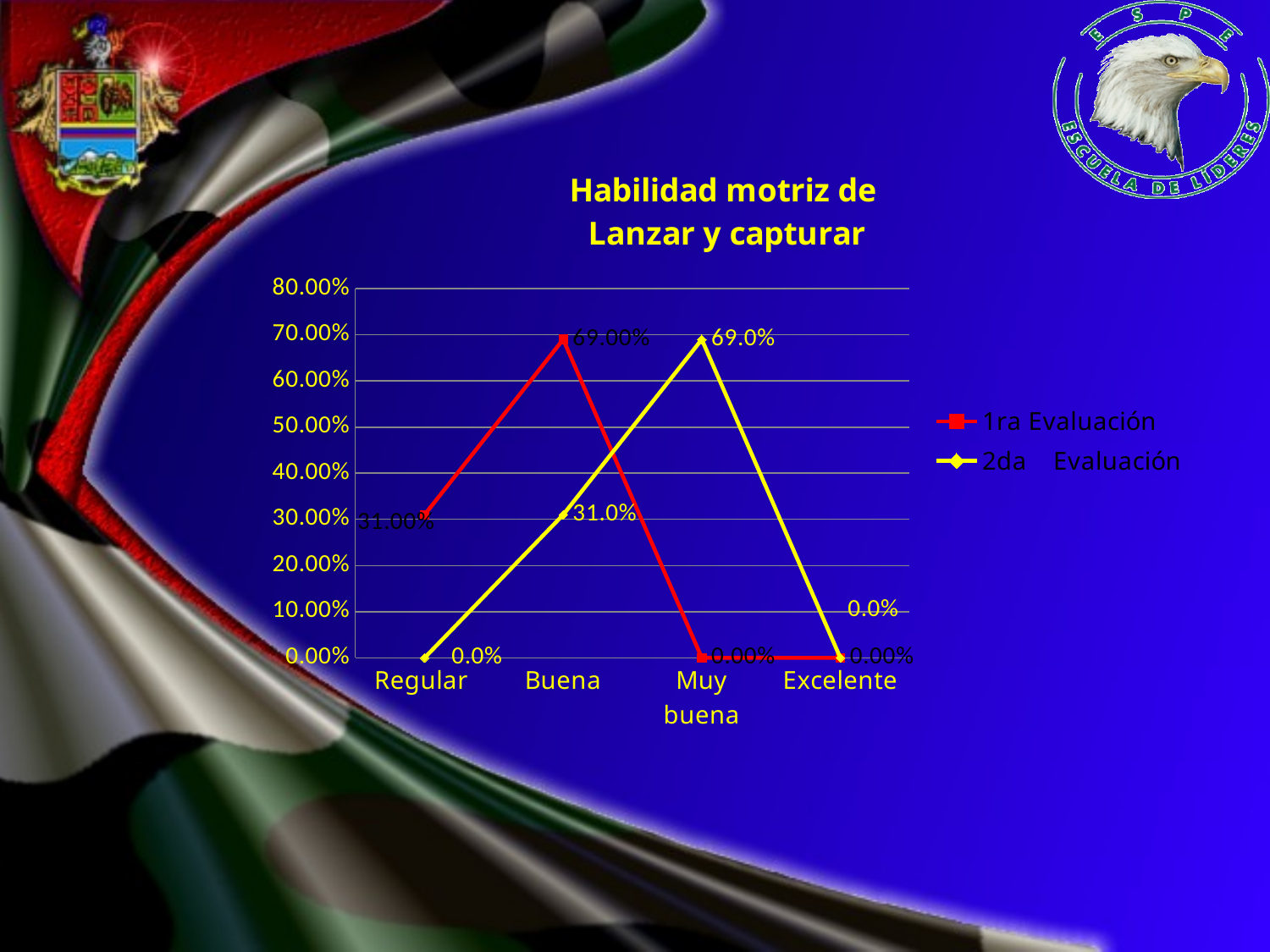
What is the value for Regular in the 1ra Evaluación series? 31.00% What is the difference between the Buena and Regular values in the 1ra Evaluación series? 38.00% How many series does the legend list? 2 Which category has the highest value in the 2da Evaluación series? Muy buena What is the value for Buena in the 2da Evaluación series? 31.0% Which category has the highest value in the 1ra Evaluación series? Buena What is the value for Buena in the 1ra Evaluación series? 69.00% What kind of chart is shown on the slide? line chart What is the title of the chart? Habilidad motriz de Lanzar y capturar What is the value for Muy buena in the 2da Evaluación series? 69.0% Which is larger for Buena: the 1ra Evaluación value or the 2da Evaluación value? 1ra Evaluación How many categories are shown on the x axis? 4